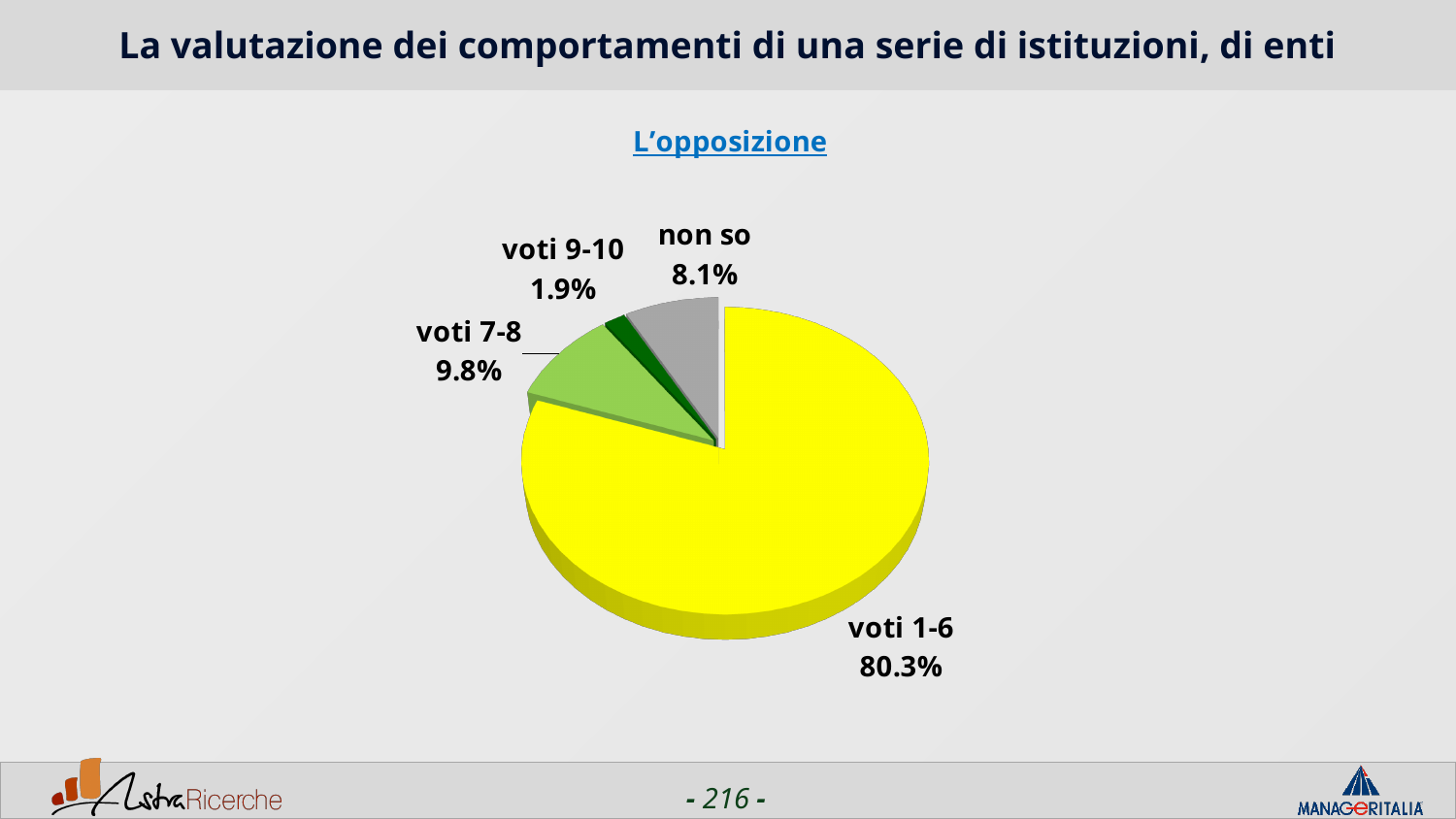
What is the title of the pie chart? L'opposizione Which is larger, the value for 'voti 7-8' or the value for 'non so'? voti 7-8 What is the value for 'non so'? 8.1% How many slices does the pie chart have? 4 Which category has the largest share of the pie? voti 1-6 Which category has the smallest share of the pie? voti 9-10 What kind of chart is shown on the slide? pie chart What colour is the slice for 'voti 1-6'? yellow What is the value for 'voti 9-10'? 1.9% What is the value for 'voti 7-8'? 9.8% What is the value for 'voti 1-6'? 80.3% What is the difference between the values for 'voti 7-8' and 'non so'? 1.7%